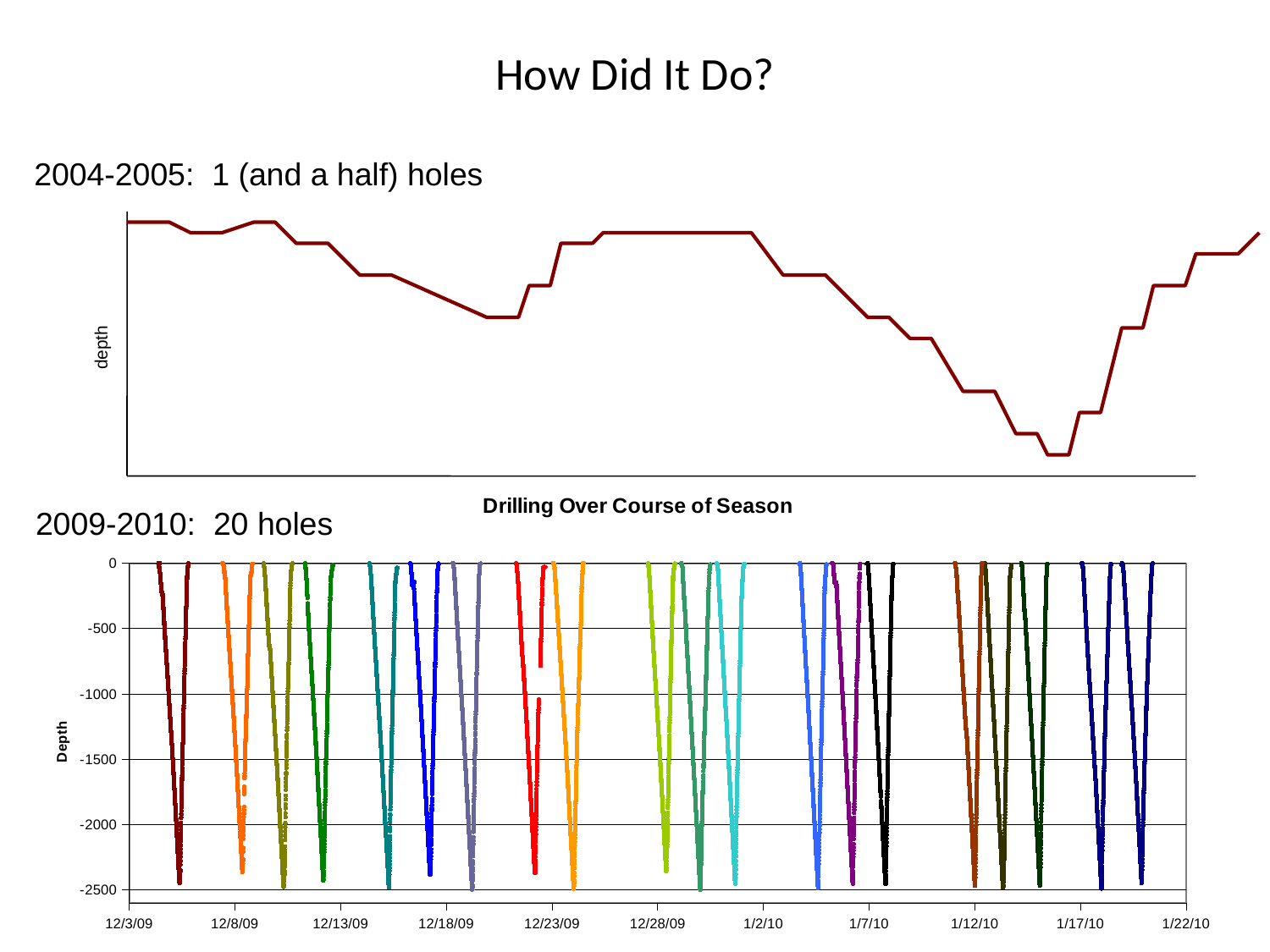
What kind of chart is the bottom chart titled "Drilling Over Course of Season"? line chart In the bottom chart, what is the last date shown on the horizontal axis? 1/22/10 In the bottom chart, is the deepest value reached by the first (dark red) hole near 12/5/09 greater or less than -2000? less What kind of chart is the top chart labelled "depth"? line chart In the bottom chart, is the deepest value reached by the orange hole near 12/8/09 greater or less than -2000? less In the bottom chart, what is the lowest value shown on the Depth axis? -2500 In the bottom chart, how many date labels are shown along the horizontal axis? 11 According to the slide, how many holes were drilled in the 2004-2005 season shown in the top chart? 1 (and a half) What is the title of the bottom chart? Drilling Over Course of Season In the bottom chart, what is the first date shown on the horizontal axis? 12/3/09 In the bottom chart, what is the label on the vertical axis? Depth According to the slide, how many holes are plotted in the bottom chart for the 2009-2010 season? 20